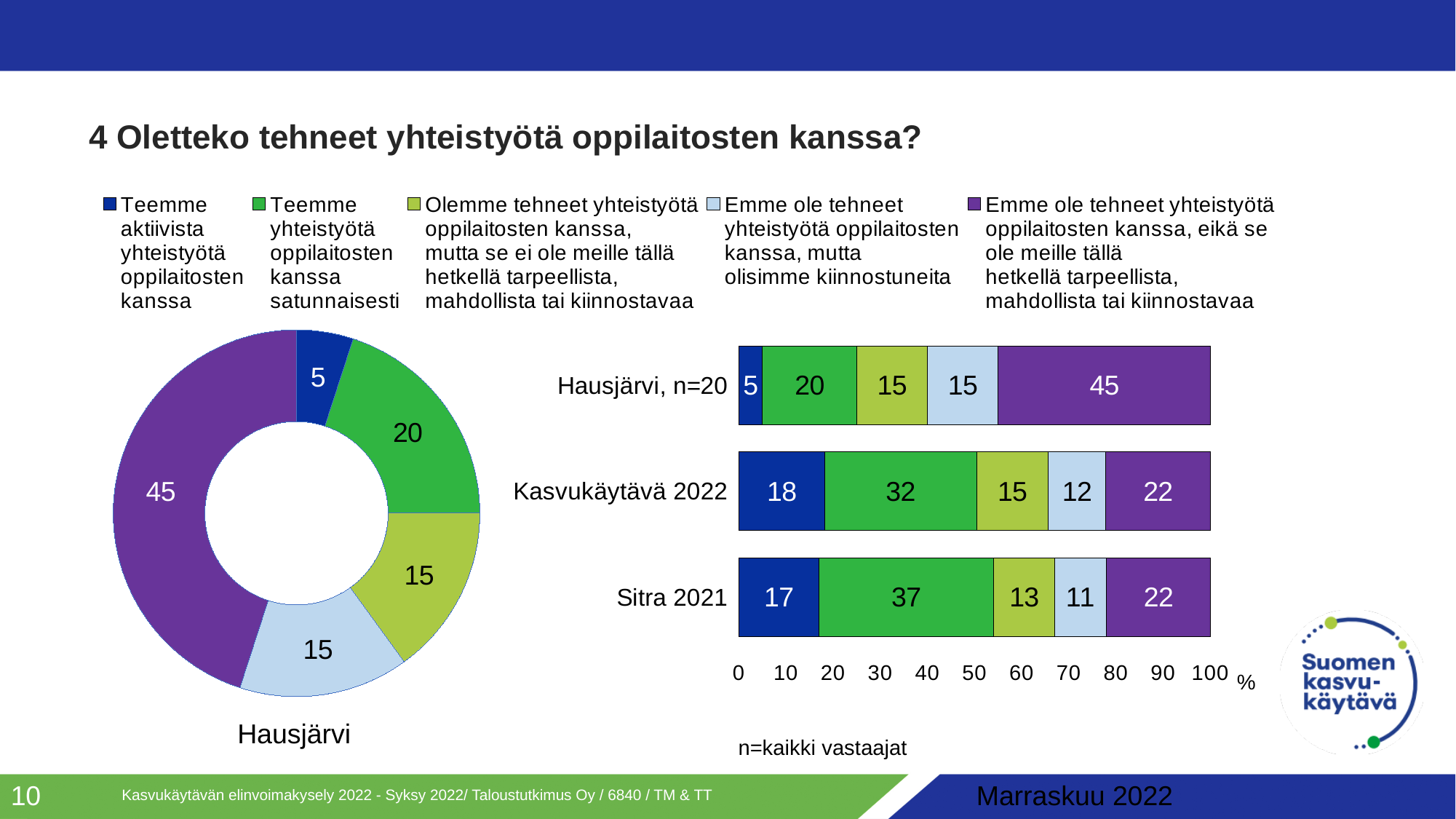
In the donut chart titled Hausjärvi, what share of the whole does the 'Teemme yhteistyötä oppilaitosten kanssa satunnaisesti' slice represent? 20% What kind of chart is the chart on the left titled Hausjärvi? Donut chart In the stacked bar chart, what is the value for 'Teemme yhteistyötä oppilaitosten kanssa satunnaisesti' for Sitra 2021? 37 How many rows (categories) does the stacked bar chart show? 3 In the stacked bar chart, which row has the highest value for 'Emme ole tehneet yhteistyötä oppilaitosten kanssa, eikä se ole meille tällä hetkellä tarpeellista, mahdollista tai kiinnostavaa'? Hausjärvi, n=20 In the stacked bar chart, which row has the lowest value for 'Teemme aktiivista yhteistyötä oppilaitosten kanssa'? Hausjärvi, n=20 In the stacked bar chart, what is the difference between the 'Teemme yhteistyötä oppilaitosten kanssa satunnaisesti' values for Sitra 2021 and Kasvukäytävä 2022? 5 In the stacked bar chart, what is the value for 'Teemme aktiivista yhteistyötä oppilaitosten kanssa' for Kasvukäytävä 2022? 18 In the stacked bar chart, what is the total of the Sitra 2021 bar? 100 In the donut chart titled Hausjärvi, what is the value of the 'Emme ole tehneet yhteistyötä oppilaitosten kanssa, eikä se ole meille tällä hetkellä tarpeellista, mahdollista tai kiinnostavaa' slice? 45 In the stacked bar chart, which is larger for Kasvukäytävä 2022: 'Olemme tehneet yhteistyötä oppilaitosten kanssa, mutta se ei ole meille tällä hetkellä tarpeellista, mahdollista tai kiinnostavaa' or 'Emme ole tehneet yhteistyötä oppilaitosten kanssa, mutta olisimme kiinnostuneita'? Olemme tehneet yhteistyötä oppilaitosten kanssa, mutta se ei ole meille tällä hetkellä tarpeellista, mahdollista tai kiinnostavaa How many series does the legend list? 5